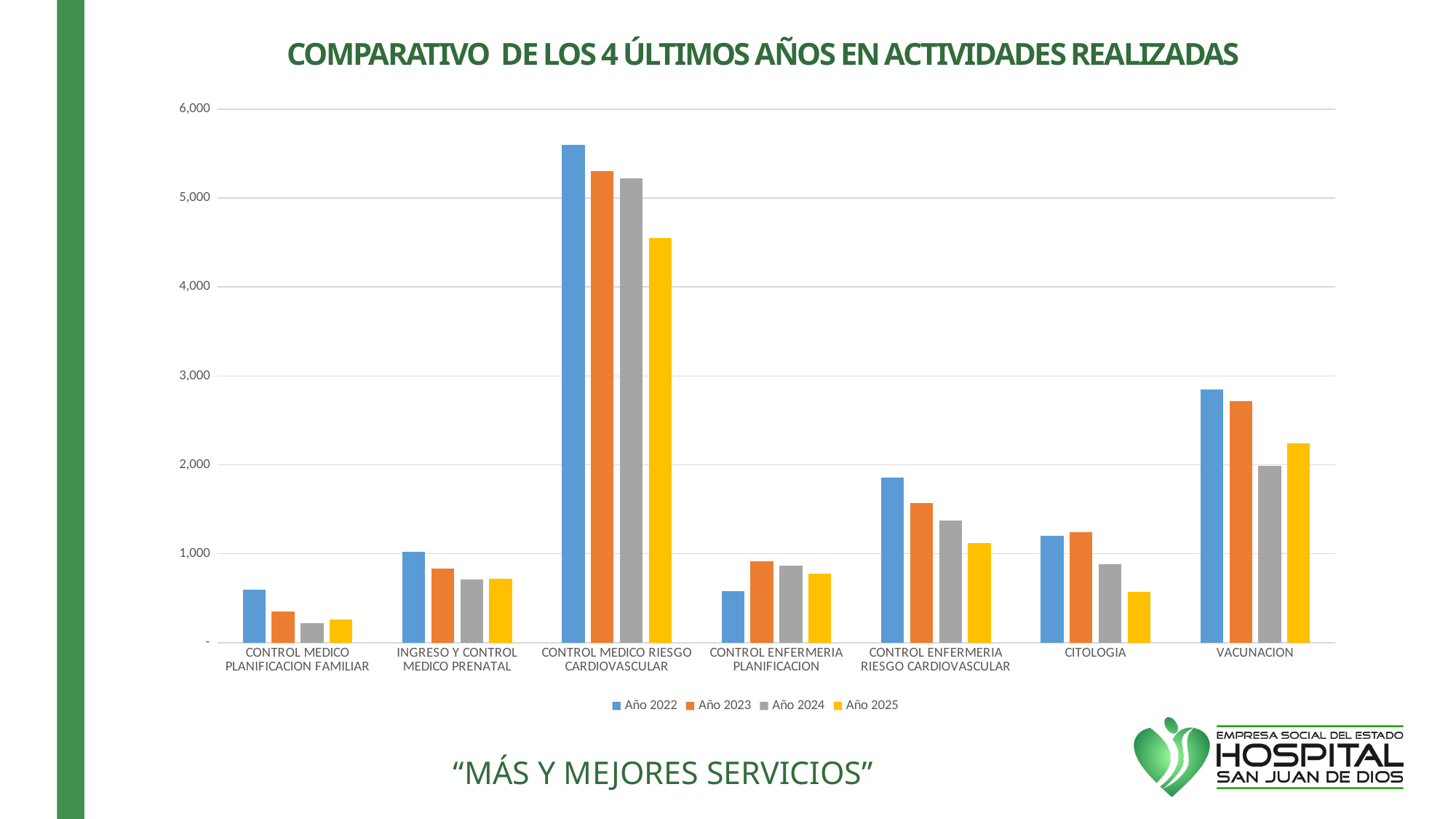
Which category has the highest value for Año 2022? CONTROL MEDICO RIESGO CARDIOVASCULAR What is the title of the chart? COMPARATIVO DE LOS 4 ÚLTIMOS AÑOS EN ACTIVIDADES REALIZADAS For VACUNACION, which is larger: the Año 2024 value or the Año 2025 value? Año 2025 For CONTROL ENFERMERIA RIESGO CARDIOVASCULAR, which is larger: the Año 2022 value or the Año 2025 value? Año 2022 Is the Año 2025 value for CONTROL MEDICO RIESGO CARDIOVASCULAR greater or less than 5,000? less Which category has the lowest value for Año 2024? CONTROL MEDICO PLANIFICACION FAMILIAR What kind of chart is shown on the slide? bar chart Is the Año 2022 value for VACUNACION greater or less than 2,000? greater Is the Año 2025 value for CITOLOGIA greater or less than 1,000? less How many categories are shown on the x axis? 7 Do the values for CONTROL ENFERMERIA RIESGO CARDIOVASCULAR rise or fall from Año 2022 to Año 2025? fall How many series does the legend list? 4